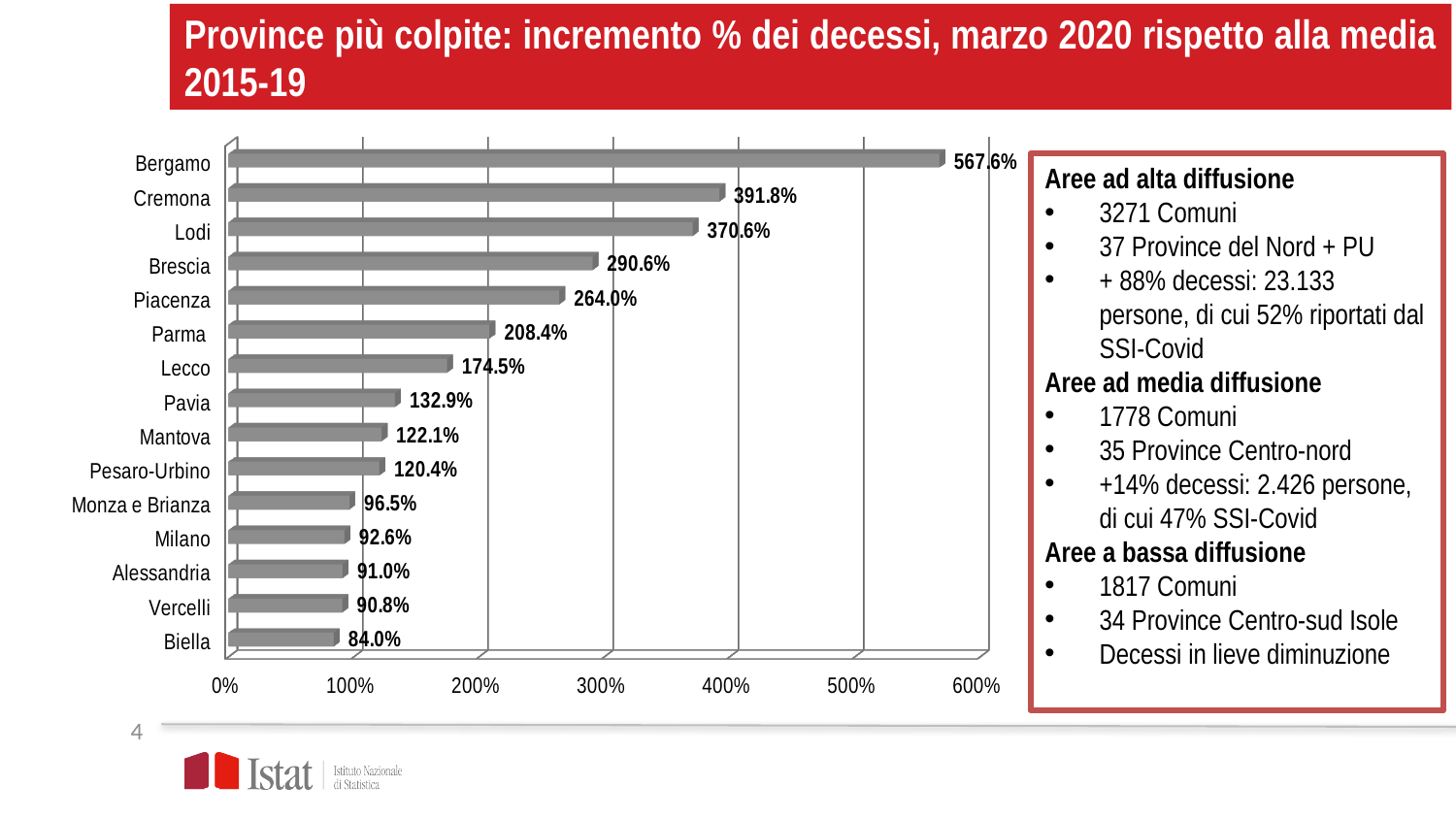
What is the value shown for Lodi? 370.6% What is the difference between the values for Brescia and Piacenza? 26.6 percentage points What kind of chart is shown on the slide? Bar chart How many provinces are shown in the chart? 15 What is the value shown for Bergamo? 567.6% Which province has the lowest value in the chart? Biella What is the difference between the values for Bergamo and Cremona? 175.8 percentage points Is the value for Piacenza greater or less than 200%? greater Which has a larger value, Lecco or Pavia? Lecco What is the value shown for Pesaro-Urbino? 120.4% Which province has the highest value in the chart? Bergamo What is the value shown for Parma? 208.4%